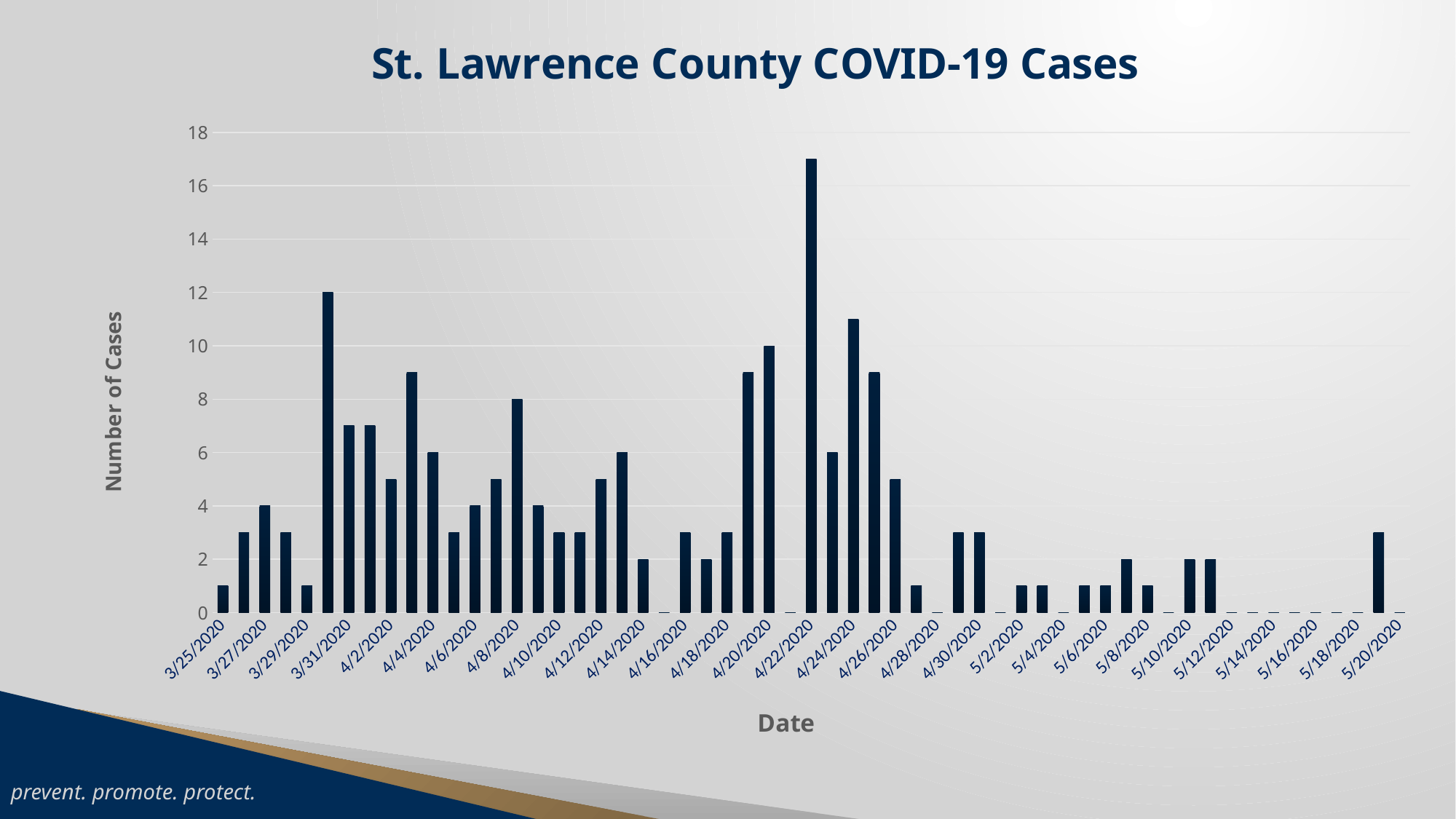
How many cases are shown for 4/20/2020? 10 What is the difference in cases between 4/20/2020 and 4/8/2020? 2 How many cases are shown for 4/14/2020? 2 Which date has more cases, 4/22/2020 or 4/24/2020? 4/22/2020 What type of chart is shown on the slide? bar chart On which date does the chart show the highest number of cases? 4/22/2020 Is the number of cases on 4/24/2020 greater or less than 10? greater How many cases are shown for 4/8/2020? 8 What is the label on the vertical axis of the chart? Number of Cases Is the number of cases on 5/20/2020 greater or less than 4? less Is the number of cases on 4/22/2020 greater or less than 16? greater What is the title of the chart? St. Lawrence County COVID-19 Cases